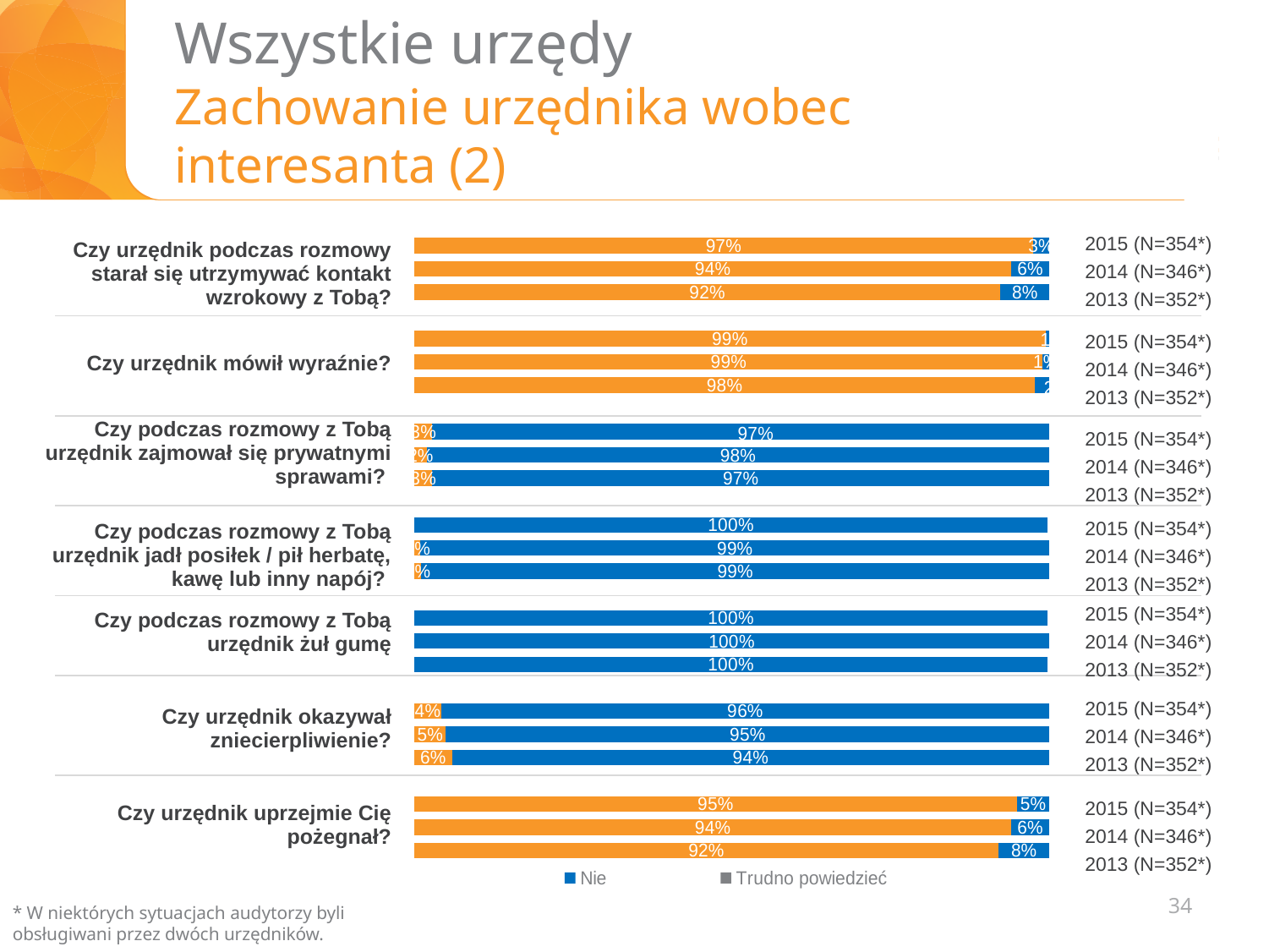
How many years are compared for each question on the chart? 3 What is the value of the blue bar for 2015 in the row "Czy urzędnik okazywał zniecierpliwienie?"? 96% What is the value of the blue bar for 2014 in the row "Czy podczas rozmowy z Tobą urzędnik zajmował się prywatnymi sprawami?"? 98% What is the sample size (N) shown for 2014? 346 What is the value of the orange bar for 2013 in the row "Czy urzędnik uprzejmie Cię pożegnał?"? 92% In the row "Czy urzędnik podczas rozmowy starał się utrzymywać kontakt wzrokowy z Tobą?", does the orange bar value rise or fall from 2013 to 2015? rise What is the value of the orange bar for 2015 in the row "Czy urzędnik podczas rozmowy starał się utrzymywać kontakt wzrokowy z Tobą?"? 97% In the row "Czy urzędnik uprzejmie Cię pożegnał?", what is the difference between the orange bar values for 2015 and 2013? 3 percentage points In the row "Czy urzędnik podczas rozmowy starał się utrzymywać kontakt wzrokowy z Tobą?", which year has the lowest orange bar value? 2013 In the row "Czy urzędnik okazywał zniecierpliwienie?", is the small orange value for 2013 larger or smaller than for 2015? larger What is the value of the orange bar for 2013 in the row "Czy urzędnik mówił wyraźnie?"? 98% What kind of chart is shown on the slide? stacked bar chart